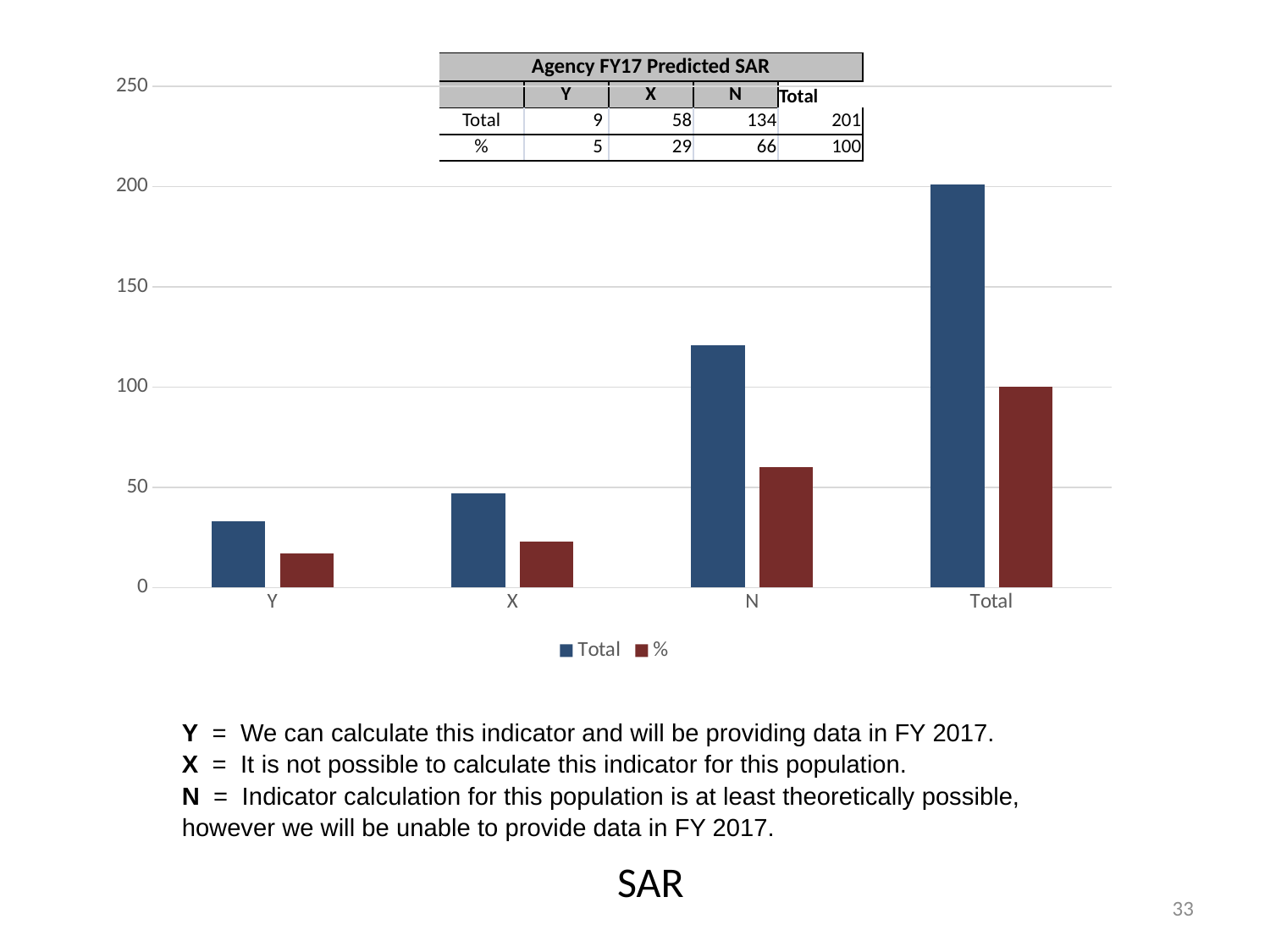
How many series does the chart legend list? 2 Which category has the lowest Total bar? Y What is the % value for the Total category? 100 Is the Total value for Y greater or less than 50? less Is the % value for N greater or less than 50? greater What kind of chart is shown on the slide? bar chart How many categories are shown on the x axis of the chart? 4 Do the Total bars rise or fall moving from Y to Total along the x axis? rise Which category has the highest Total bar? Total What are the two entries in the chart legend? Total and % Is the Total value for N greater or less than 100? greater Which is larger, the Total bar for N or the Total bar for X? N